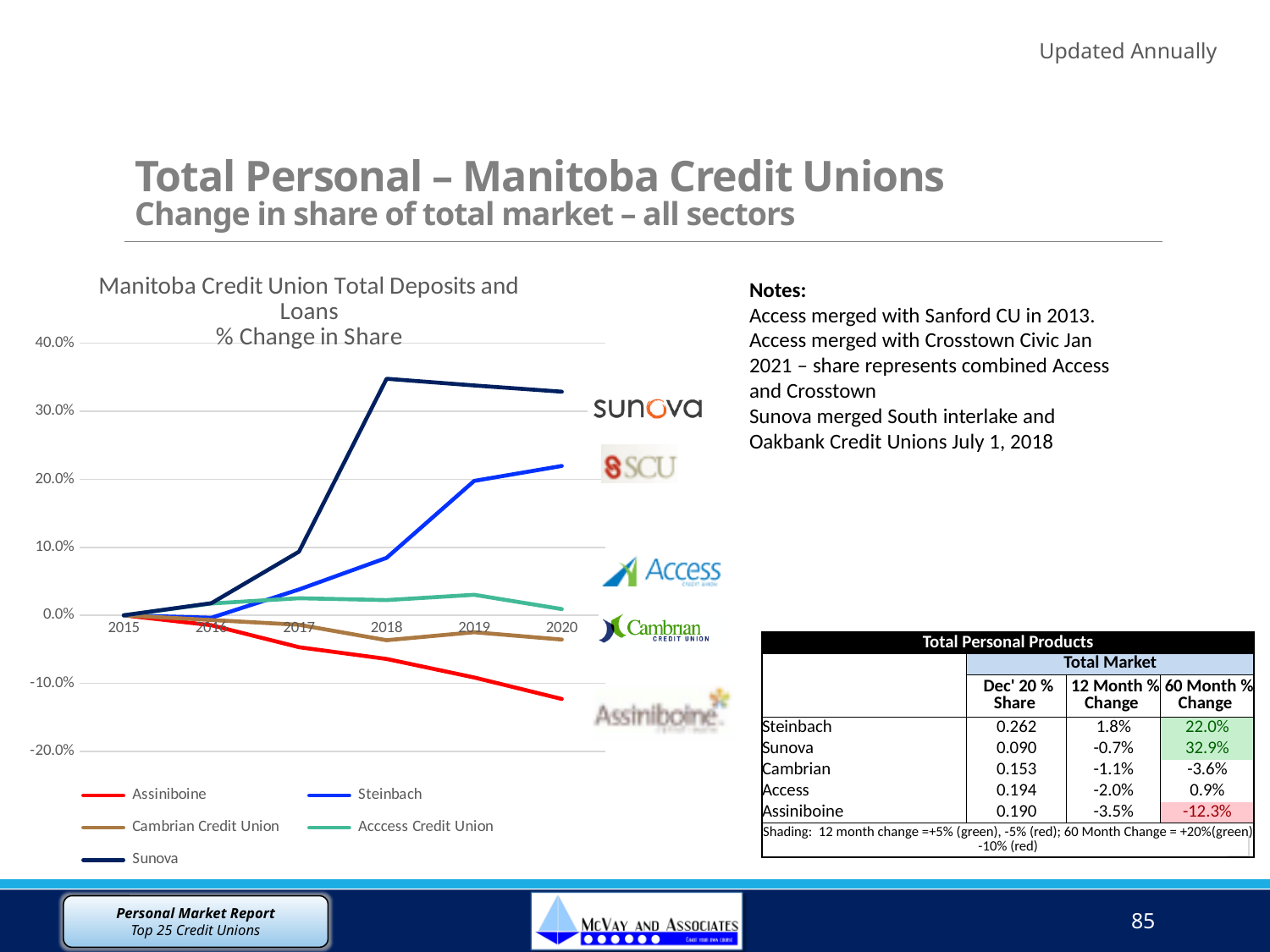
Is the value for Steinbach in 2018 greater or less than 10.0%? less In 2020, which is larger: the value for Sunova or the value for Steinbach? Sunova Does the Assiniboine line rise or fall from 2015 to 2020? fall Which credit union has the highest % change in share in 2020? Sunova Which credit union has the lowest % change in share in 2020? Assiniboine What kind of chart is shown on the slide? line chart Is the value for Steinbach in 2020 greater or less than 20.0%? greater How many years are shown along the x axis of the chart? 6 Is the value for Assiniboine in 2020 greater or less than -10.0%? less What colour is the Assiniboine line in the chart? red How many series does the chart legend list? 5